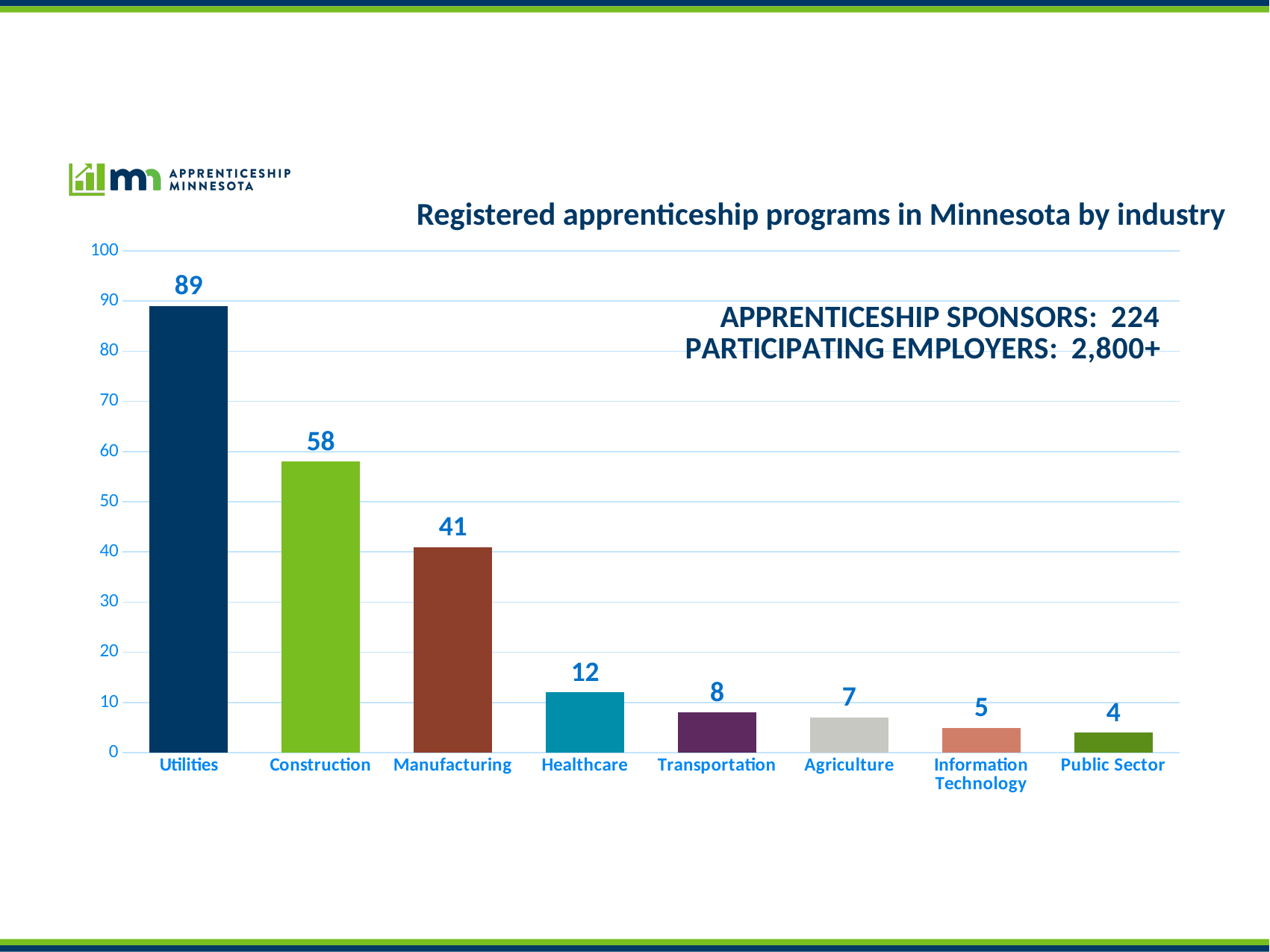
What is the value shown for Manufacturing? 41 Which industry has the lowest number of registered apprenticeship programs? Public Sector Is the value for Construction greater or less than 50? greater Which has more registered apprenticeship programs, Agriculture or Transportation? Transportation What kind of chart is shown on the slide? Bar chart What is the value shown for Information Technology? 5 What is the title of the chart? Registered apprenticeship programs in Minnesota by industry What is the difference between the values for Healthcare and Transportation? 4 Which industry has the highest number of registered apprenticeship programs? Utilities What is the difference between the values for Utilities and Construction? 31 How many industries are shown on the chart? 8 How many registered apprenticeship programs are in the Utilities industry? 89